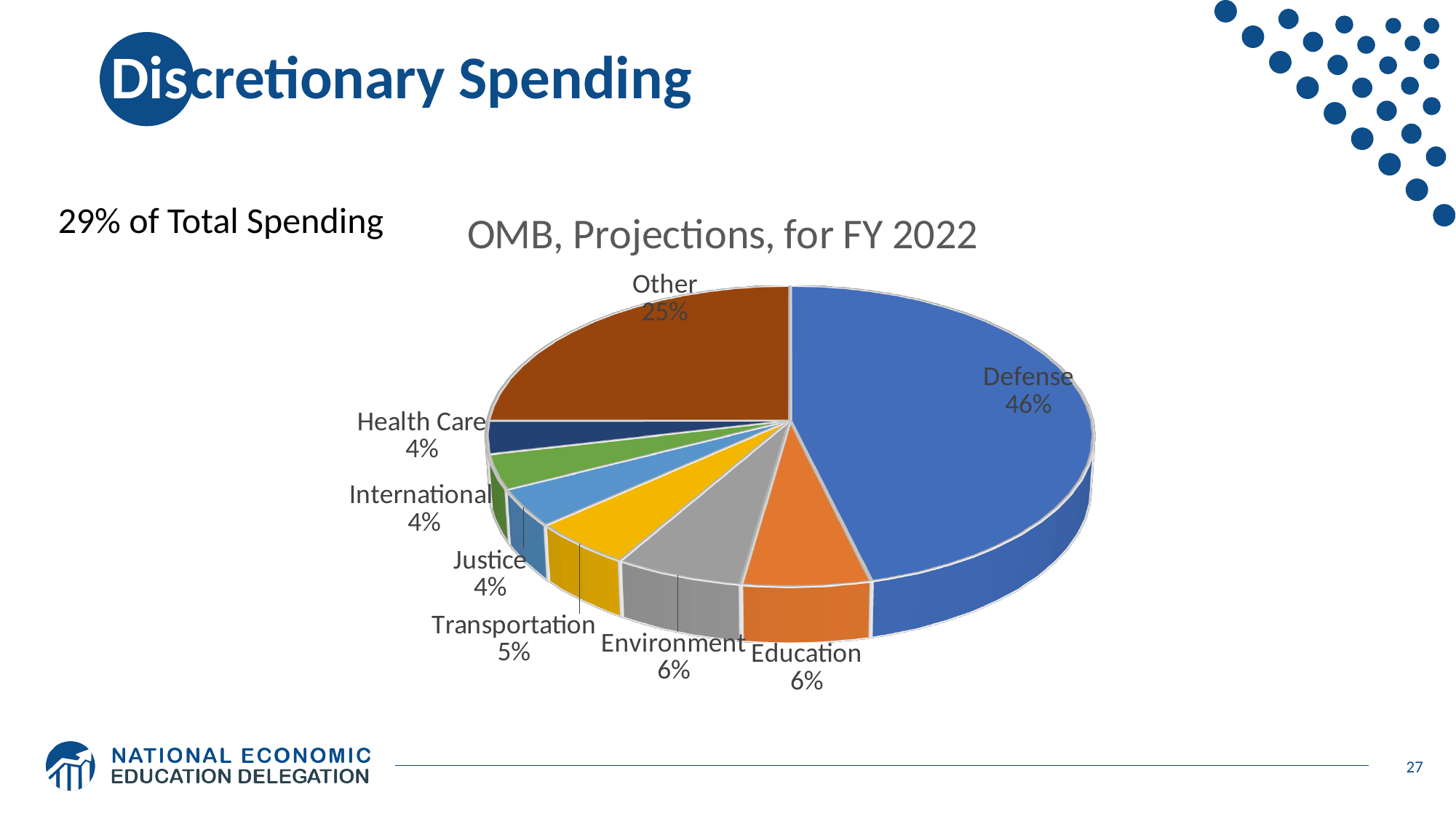
What is the title of the pie chart? OMB, Projections, for FY 2022 How many slices does the pie chart have? 8 What is the value shown for Education? 6% What kind of chart is shown on the slide? pie chart What is the difference in percentage points between Defense and Other? 21% Which category has the largest slice of the pie? Defense What colour is the Defense slice? blue What is the value shown for the Other slice? 25% Which is larger, the Environment slice or the Transportation slice? Environment What percentage is shown for Health Care? 4% What share of discretionary spending goes to Defense? 46% What percentage is shown for Transportation? 5%